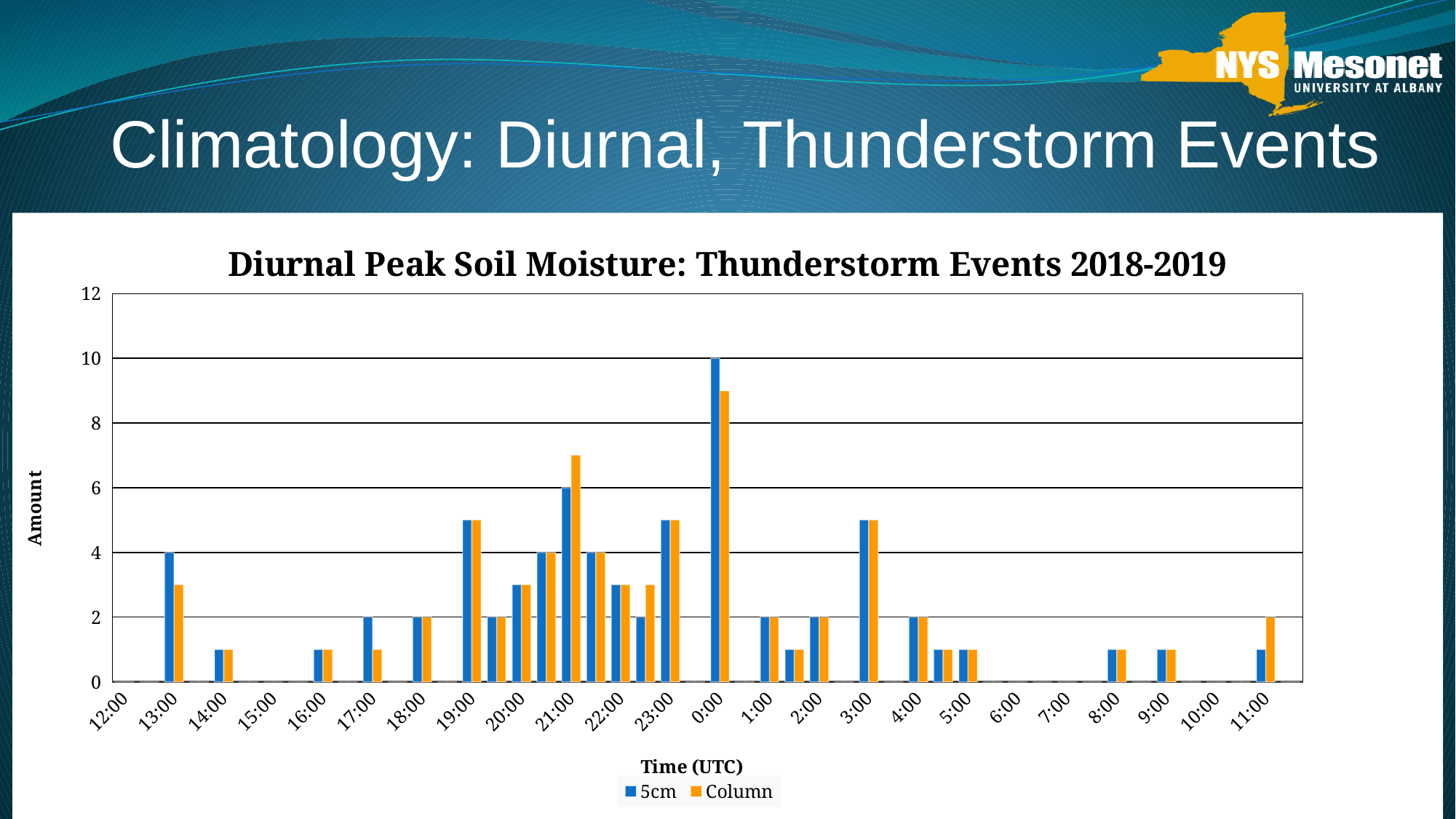
At which time is the 5cm series highest? 0:00 What is the 5cm value at 13:00? 4 What is the difference between the 5cm value at 13:00 and the 5cm value at 18:00? 2 What is the 5cm value at 21:00? 6 What is the label of the vertical axis? Amount How many series does the legend list? 2 Is the Column value at 0:00 greater or less than 8? greater What is the 5cm value at 0:00? 10 What kind of chart is shown on the slide? Bar chart What is the Column value at 18:00? 2 What is the title of the chart? Diurnal Peak Soil Moisture: Thunderstorm Events 2018-2019 At 21:00, which series has the larger value, 5cm or Column? Column